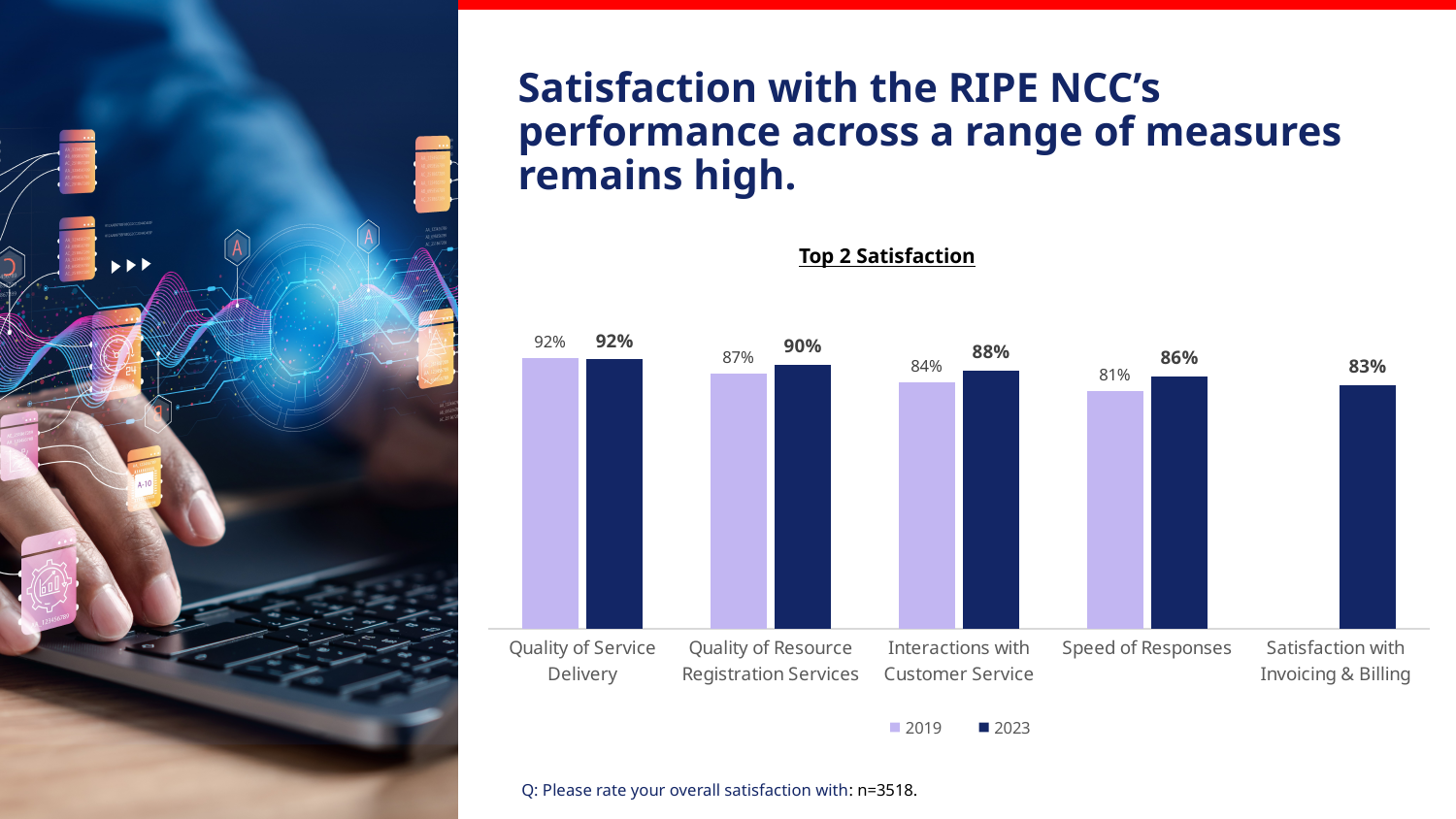
What is the 2023 value for Satisfaction with Invoicing & Billing? 83% How many categories are shown on the x axis? 5 What is the 2023 value for Quality of Service Delivery? 92% What is the title of the chart? Top 2 Satisfaction How many series does the legend list? 2 Which is larger for Quality of Resource Registration Services: the 2019 value or the 2023 value? 2023 What kind of chart is shown? Bar chart What is the 2019 value for Interactions with Customer Service? 84% Which category has the highest 2023 value? Quality of Service Delivery What is the 2019 value for Speed of Responses? 81% Which category has the lowest 2019 value? Speed of Responses What is the difference between the 2023 and 2019 values for Speed of Responses? 5%